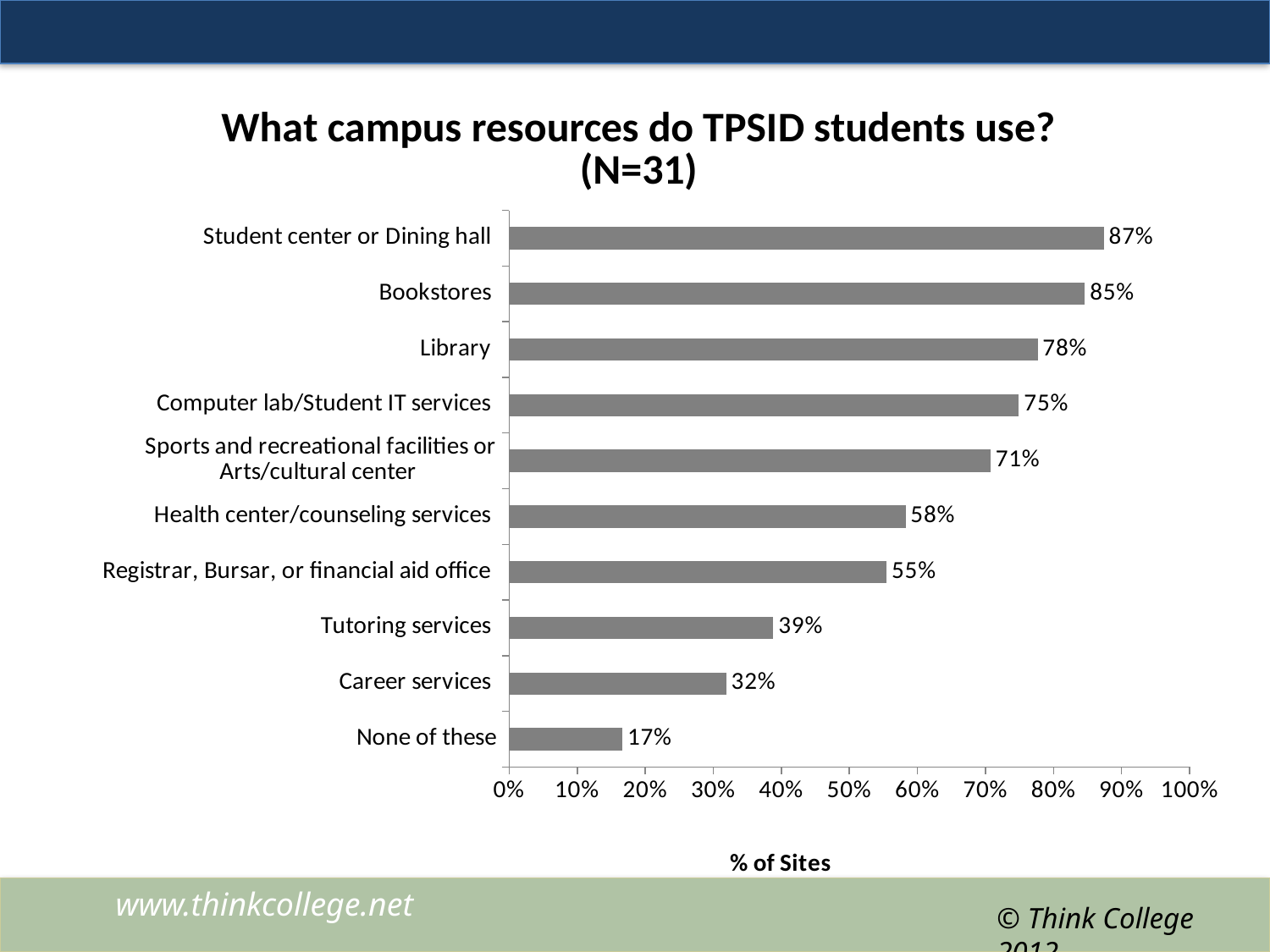
What percentage of sites use the Library? 78% How many categories are shown on the chart? 10 Which category has the lowest value on the chart? None of these What is the label of the horizontal axis? % of Sites What is the sample size (N) given in the chart title? 31 What kind of chart is shown on the slide? Bar chart Is the value for Computer lab/Student IT services greater or less than 70%? greater What is the value for Tutoring services? 39% What percentage of sites reported None of these? 17% Which campus resource has the highest percentage of sites? Student center or Dining hall What is the difference between the values for Bookstores and Career services? 53% Which is larger: Health center/counseling services or Registrar, Bursar, or financial aid office? Health center/counseling services